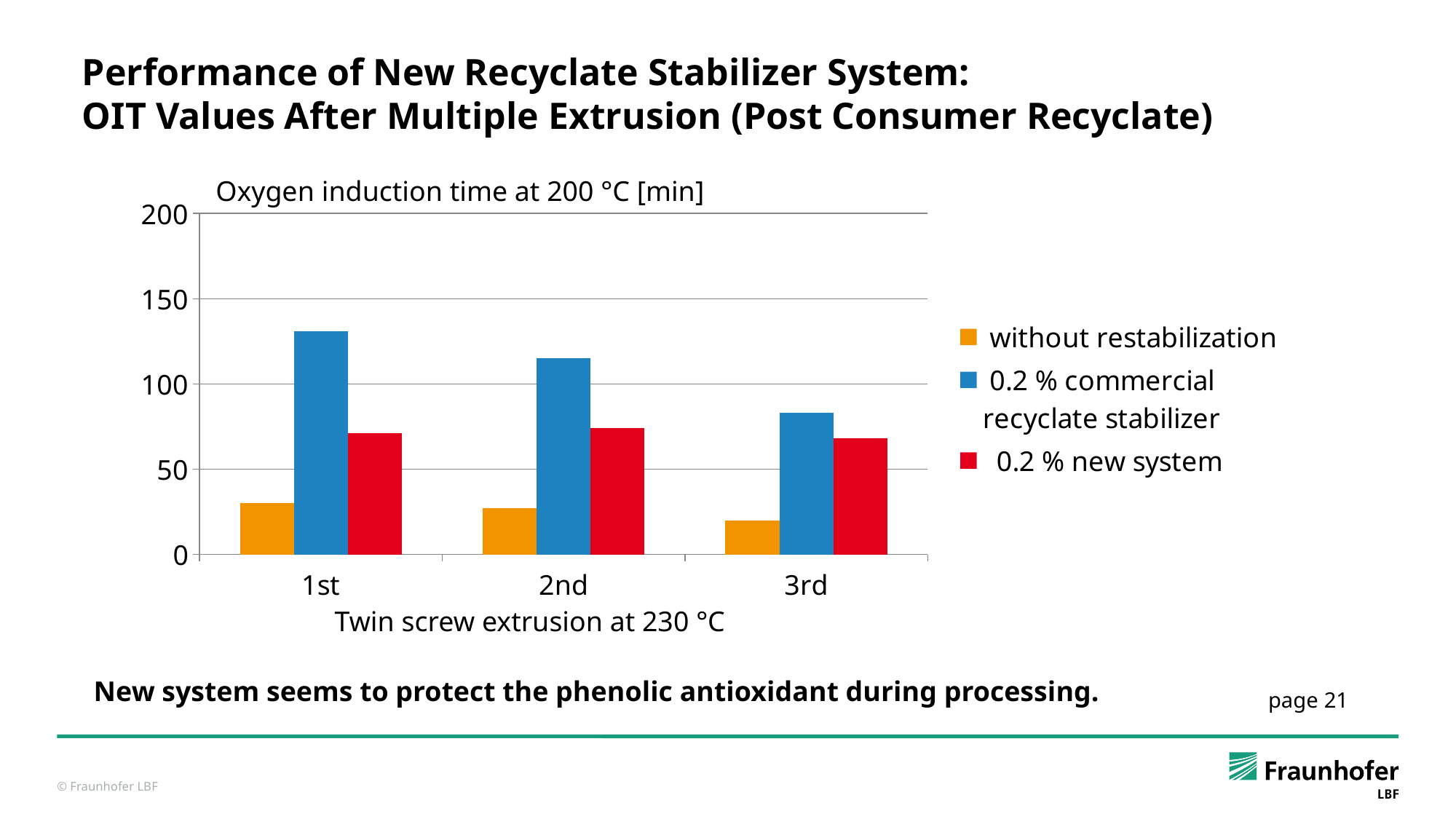
How many series does the legend list? 3 Is the value for 0.2 % new system at the 3rd extrusion greater or less than 50? greater At the 3rd extrusion, which is larger: without restabilization or 0.2 % new system? 0.2 % new system Is the value for 0.2 % commercial recyclate stabilizer at the 1st extrusion greater or less than 100? greater Do the values for 0.2 % commercial recyclate stabilizer rise or fall from the 1st to the 3rd extrusion? fall Which series has the highest bar at the 1st extrusion? 0.2 % commercial recyclate stabilizer Is the value for without restabilization at the 1st extrusion greater or less than 50? less How many extrusion passes are shown on the x axis? 3 What kind of chart is shown on the slide? bar chart What is the label of the x axis? Twin screw extrusion at 230 °C Which series has the lowest bar at the 3rd extrusion? without restabilization